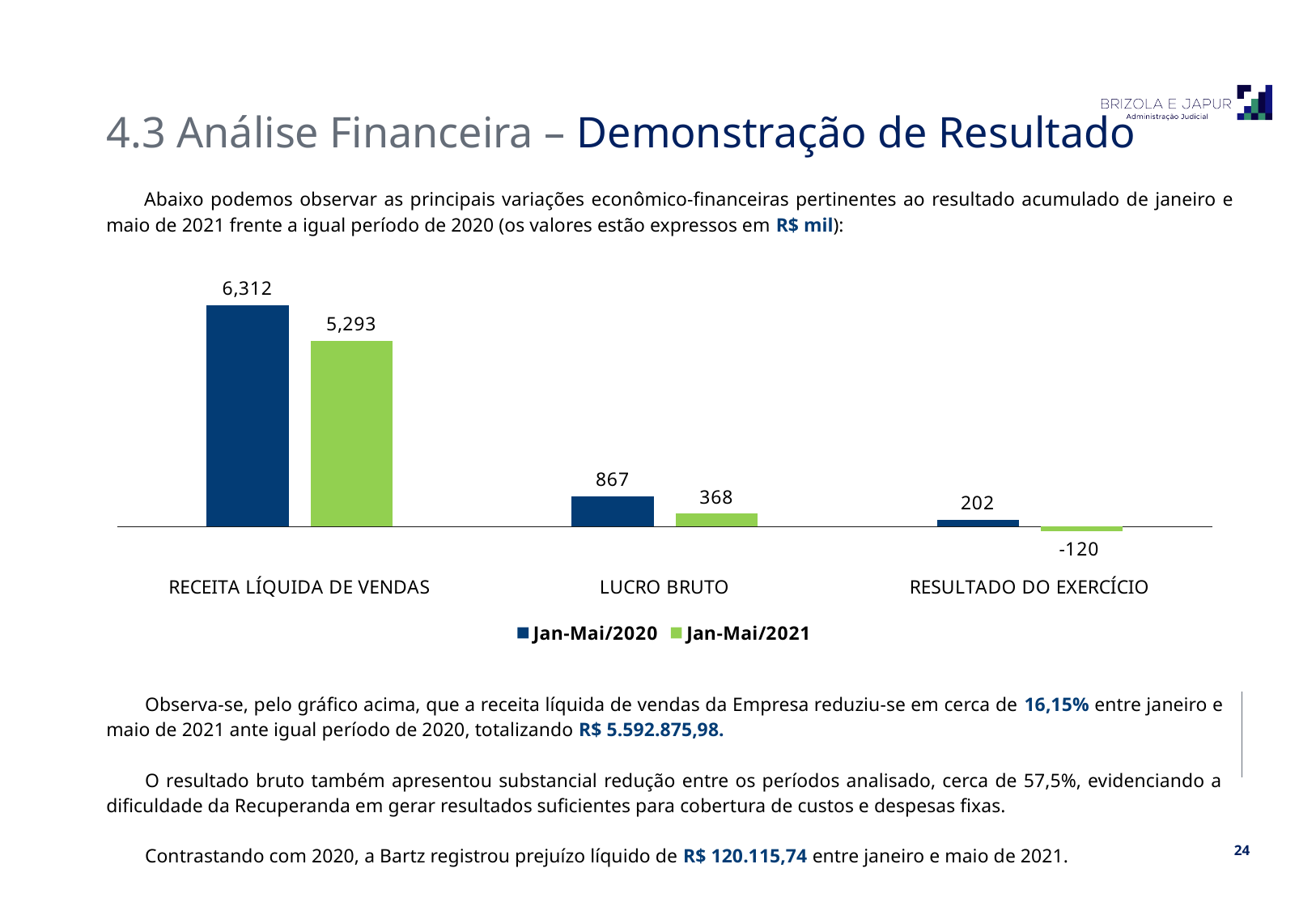
What is the difference between the Jan-Mai/2020 and Jan-Mai/2021 values for LUCRO BRUTO? 499 How many categories are shown on the x axis of the chart? 3 How many series does the legend list? 2 What is the value for RESULTADO DO EXERCÍCIO in the Jan-Mai/2020 series? 202 Which is larger for LUCRO BRUTO: the Jan-Mai/2020 value or the Jan-Mai/2021 value? Jan-Mai/2020 What is the value for LUCRO BRUTO in the Jan-Mai/2021 series? 368 What is the difference between the Jan-Mai/2020 and Jan-Mai/2021 values for RECEITA LÍQUIDA DE VENDAS? 1,019 What kind of chart is shown on the slide? Bar chart Which category has the highest value in the Jan-Mai/2021 series? RECEITA LÍQUIDA DE VENDAS What is the value for RECEITA LÍQUIDA DE VENDAS in the Jan-Mai/2020 series? 6,312 Which category has the lowest value in the Jan-Mai/2020 series? RESULTADO DO EXERCÍCIO What is the value for RESULTADO DO EXERCÍCIO in the Jan-Mai/2021 series? -120